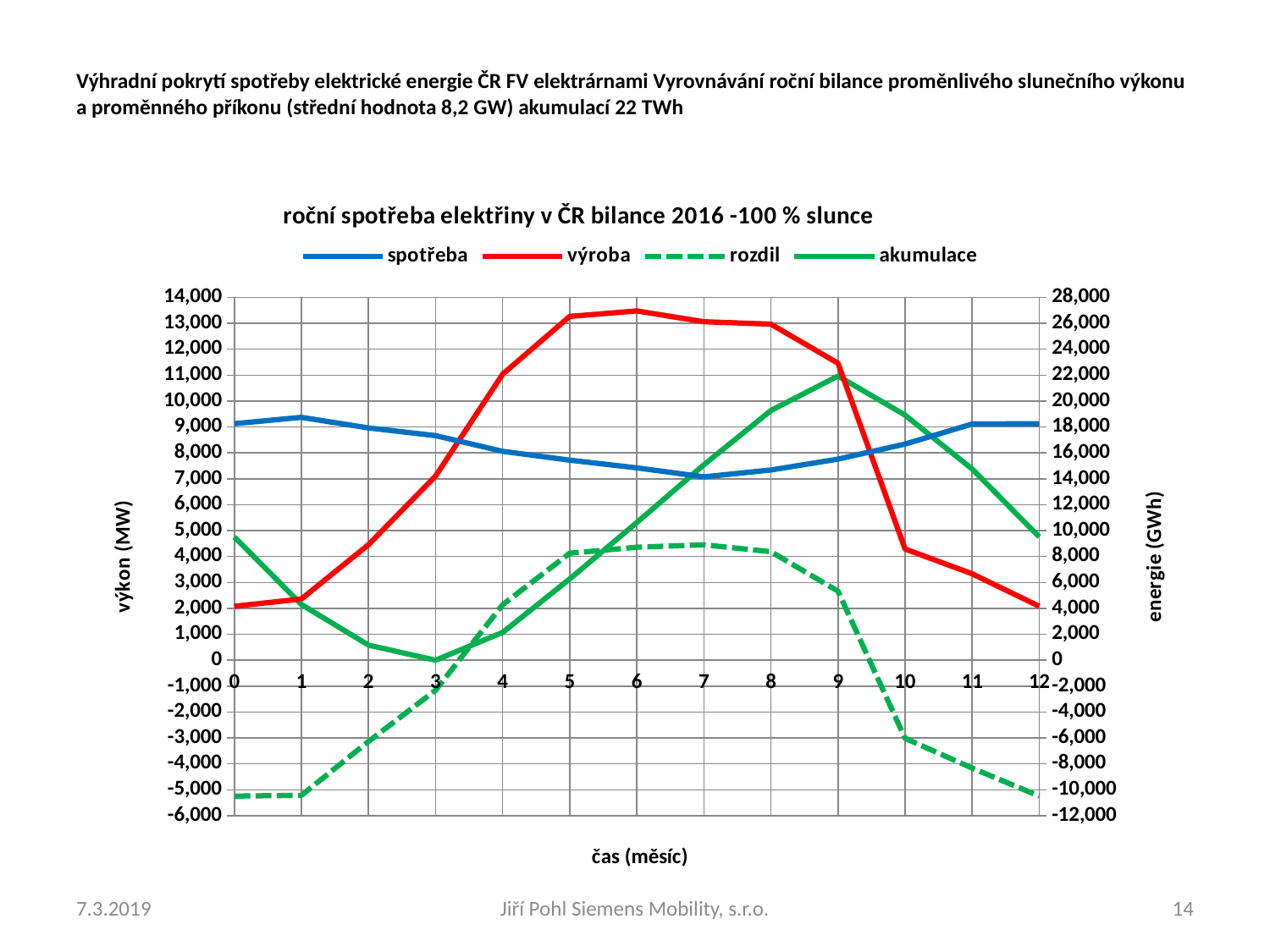
Is the value of výroba at month 6 greater or less than 12,000 on the left axis? greater Is the value of výroba at month 0 greater or less than 3,000 on the left axis? less How many series does the chart legend list? 4 At which month does the akumulace series reach its highest value? 9 What kind of chart is shown on the slide? line chart At which month does the výroba series reach its highest value? 6 What is the title of the chart? roční spotřeba elektřiny v ČR bilance 2016 -100 % slunce What is the label of the x axis of the chart? čas (měsíc) Does the výroba series rise or fall between month 0 and month 6? rise At which month does the spotřeba series reach its lowest value? 7 At month 3, which series has the larger value: spotřeba or výroba? spotřeba Is the value of spotřeba at month 7 greater or less than 8,000 on the left axis? less